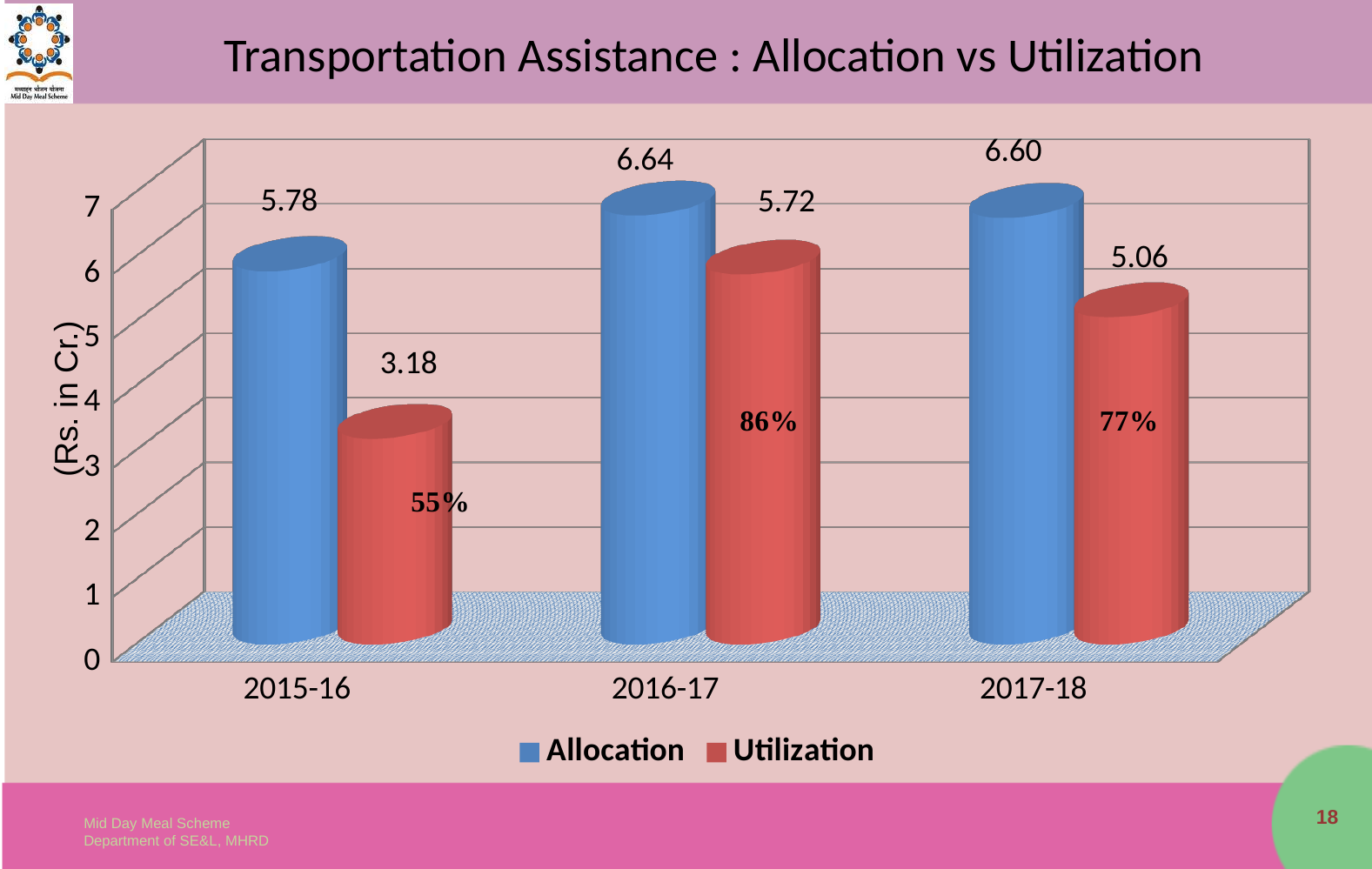
How many series does the legend list? 2 What kind of chart is shown on the slide? Bar chart What is the difference between Allocation and Utilization in 2015-16? 2.60 What is the Utilization value for 2016-17? 5.72 Which is larger in 2017-18, Allocation or Utilization? Allocation What percentage label is shown on the Utilization bar for 2016-17? 86% Which year has the lowest Utilization? 2015-16 Which year has the highest Allocation? 2016-17 What is the unit shown on the y axis label? Rs. in Cr. What is the Allocation value for 2015-16? 5.78 What is the Utilization value for 2017-18? 5.06 How many years are shown on the x axis? 3